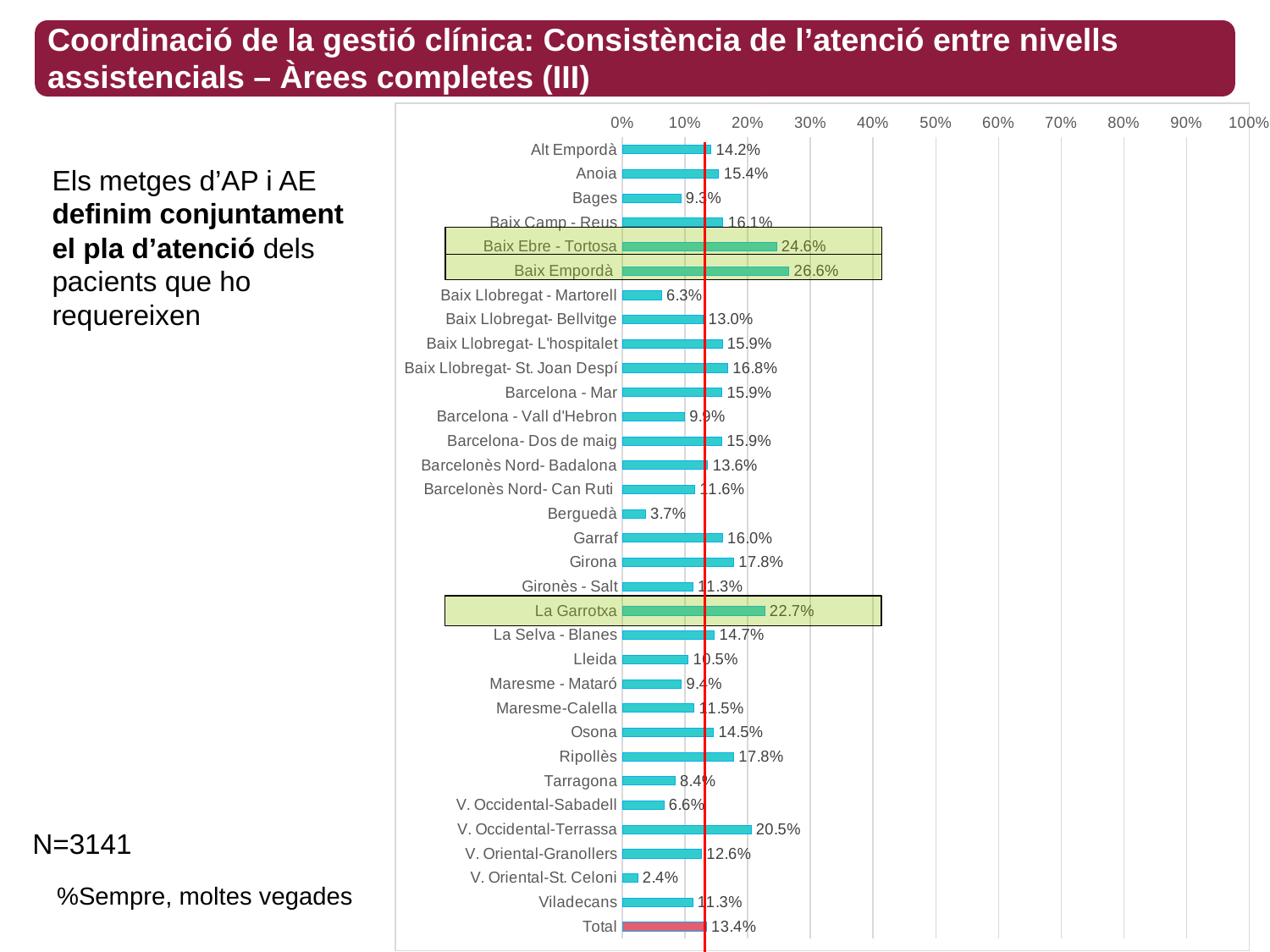
What is the difference between Baix Empordà and Baix Ebre - Tortosa? 2.0% Which area has the lowest value? V. Oriental-St. Celoni What kind of chart is shown on the slide? Bar chart Is the value for Berguedà greater or less than 10%? less How many bars are plotted in the chart, including Total? 33 What is the sample size (N) shown on the slide? N=3141 Which area has the highest value? Baix Empordà What is the value for Total? 13.4% What is the value for Baix Empordà? 26.6% Which is larger, the value for Girona or the value for Lleida? Girona What is the value for La Garrotxa? 22.7% What is the value for V. Occidental-Terrassa? 20.5%